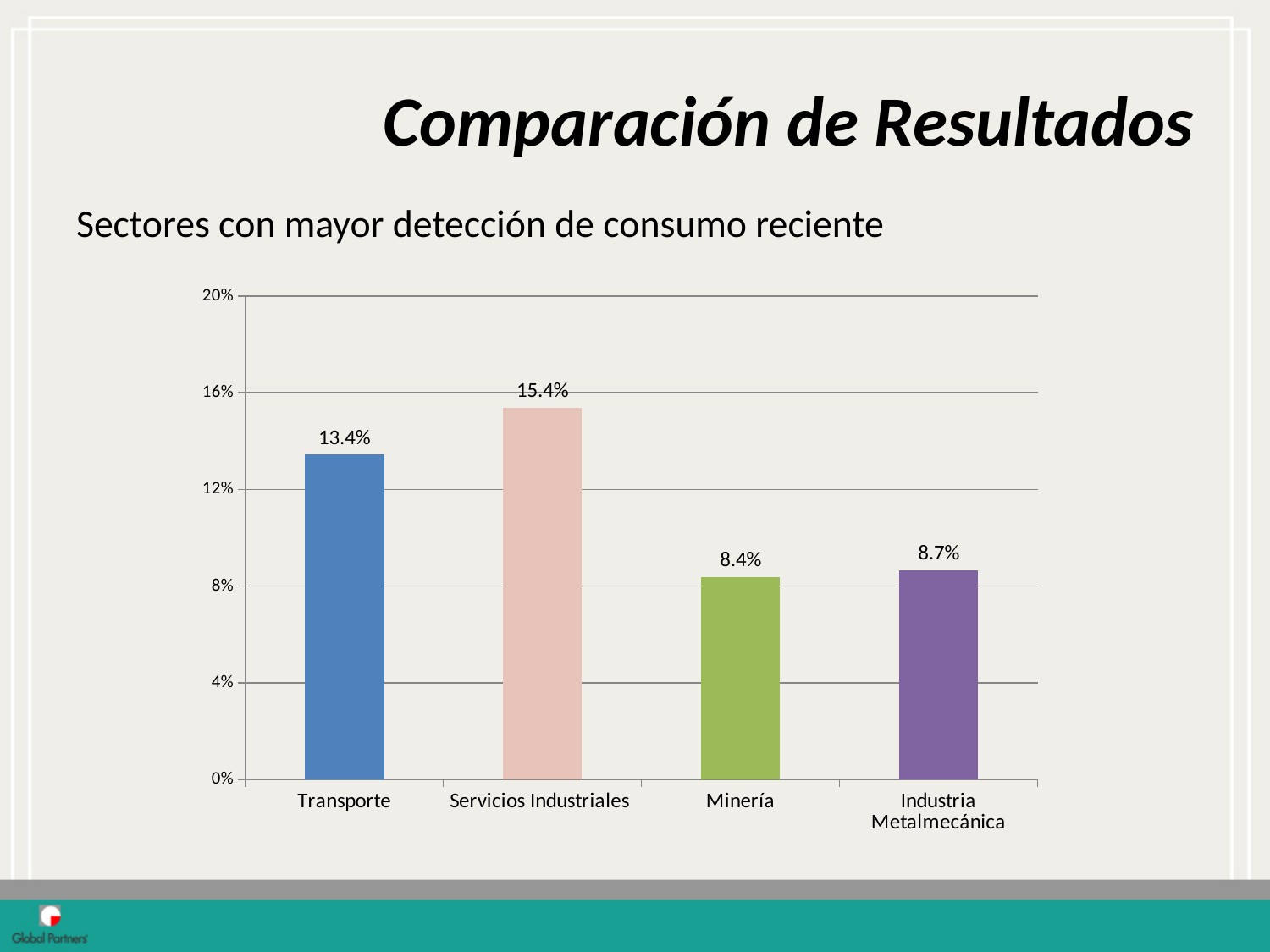
Which sector has the lowest value? Minería Is the value for Servicios Industriales greater or less than 12%? greater What is the value for Industria Metalmecánica? 8.7% How many sectors are shown in the chart? 4 What is the value for Servicios Industriales? 15.4% Which is larger, the value for Transporte or the value for Minería? Transporte Which sector has the highest value? Servicios Industriales What is the value for Transporte? 13.4% What is the difference between the values for Servicios Industriales and Transporte? 2.0% What is the subtitle above the chart? Sectores con mayor detección de consumo reciente What is the value for Minería? 8.4% What kind of chart is shown on the slide? bar chart